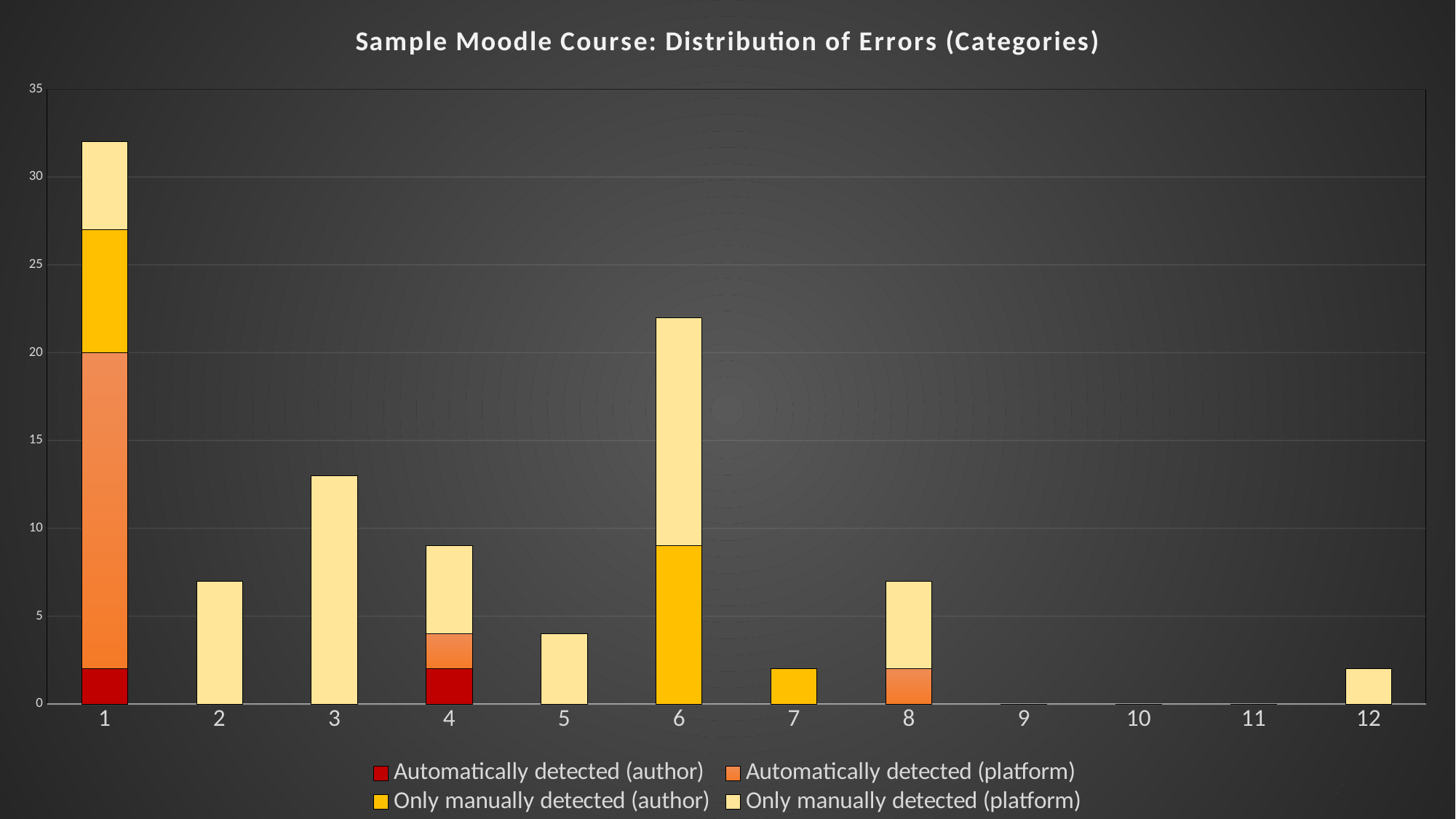
Is the total for category 3 greater or less than 15? less What is the title of the chart? Sample Moodle Course: Distribution of Errors (Categories) Which bar is taller, category 2 or category 4? category 4 Which category has the tallest bar? 1 Is the total for category 1 greater or less than 30? greater How many series does the legend list? 4 What kind of chart is shown on the slide? bar chart How many categories are shown on the x axis? 12 Is the total for category 5 greater or less than 5? less Which category has the second tallest bar? 6 Which bar is taller, category 3 or category 6? category 6